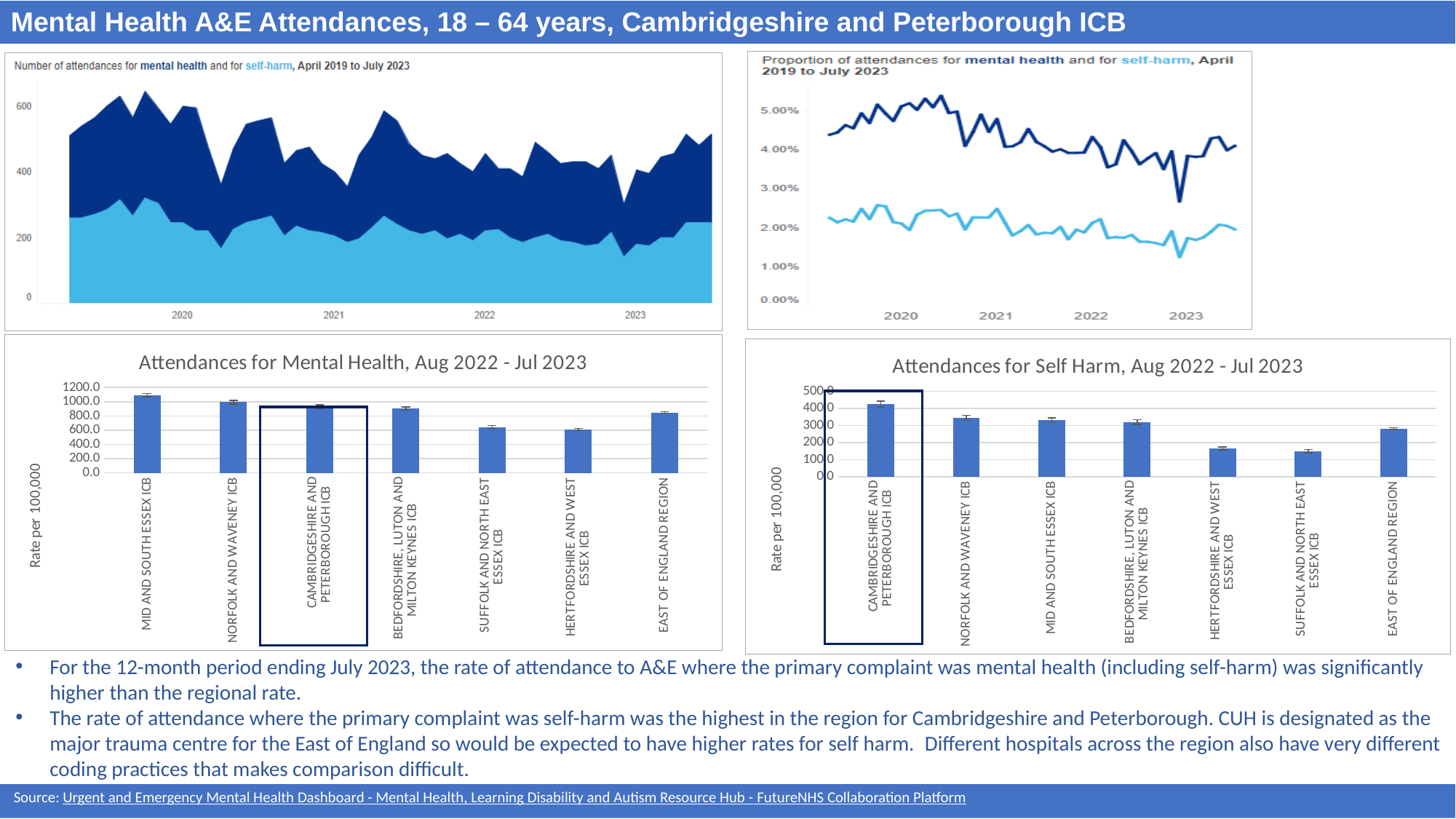
In the 'Attendances for Self Harm, Aug 2022 - Jul 2023' chart, is the value for NORFOLK AND WAVENEY ICB greater or less than 300? greater How many categories are shown in the 'Attendances for Mental Health, Aug 2022 - Jul 2023' chart? 7 In the 'Attendances for Mental Health, Aug 2022 - Jul 2023' chart, which category has the highest rate? MID AND SOUTH ESSEX ICB In the 'Attendances for Mental Health, Aug 2022 - Jul 2023' chart, is the value for MID AND SOUTH ESSEX ICB greater or less than 1000.0? greater In the 'Attendances for Self Harm, Aug 2022 - Jul 2023' chart, which is larger: the value for CAMBRIDGESHIRE AND PETERBOROUGH ICB or the value for EAST OF ENGLAND REGION? CAMBRIDGESHIRE AND PETERBOROUGH ICB In the 'Attendances for Mental Health, Aug 2022 - Jul 2023' chart, is the value for HERTFORDSHIRE AND WEST ESSEX ICB greater or less than 800.0? less In the 'Attendances for Self Harm, Aug 2022 - Jul 2023' chart, which category has the highest rate? CAMBRIDGESHIRE AND PETERBOROUGH ICB What kind of chart is 'Attendances for Self Harm, Aug 2022 - Jul 2023'? bar chart What is the y-axis label of the 'Attendances for Mental Health, Aug 2022 - Jul 2023' chart? Rate per 100,000 In the 'Attendances for Mental Health, Aug 2022 - Jul 2023' chart, which is larger: the value for NORFOLK AND WAVENEY ICB or the value for SUFFOLK AND NORTH EAST ESSEX ICB? NORFOLK AND WAVENEY ICB What kind of chart is the top-right chart, 'Proportion of attendances for mental health and for self-harm, April 2019 to July 2023'? line chart